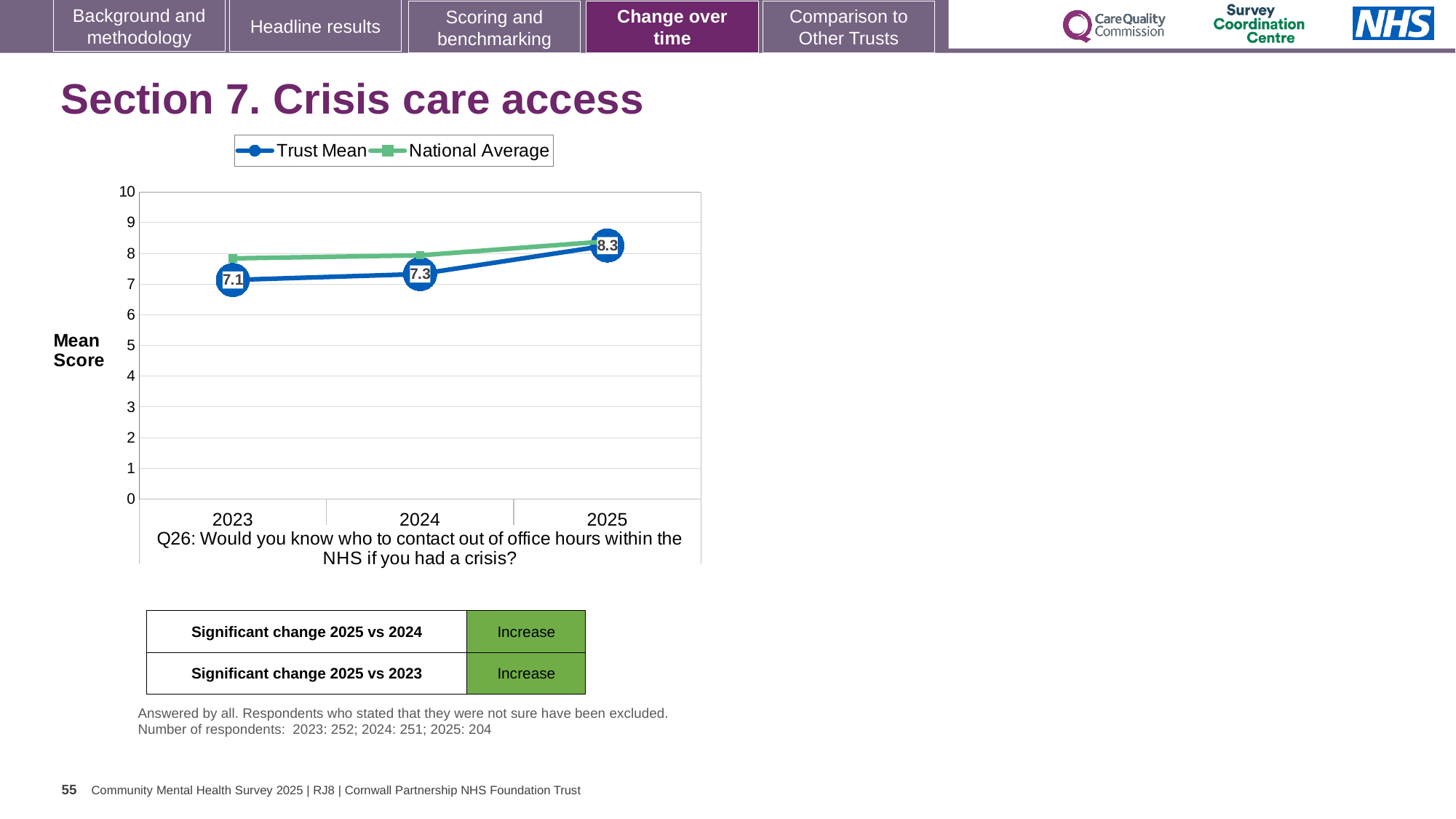
What is the Trust Mean score for 2023? 7.1 In 2023, which is higher: the Trust Mean or the National Average? National Average By how much did the Trust Mean score change from 2023 to 2025? 1.2 What is the Trust Mean score for 2025? 8.3 What is the Trust Mean score for 2024? 7.3 By how much did the Trust Mean score change from 2024 to 2025? 1.0 In which year is the Trust Mean score lowest? 2023 Is the National Average value for 2023 greater or less than 7? greater How many series does the legend list? 2 In which year is the Trust Mean score highest? 2025 Does the Trust Mean rise or fall from 2023 to 2025? rise What kind of chart is shown on the slide? line chart